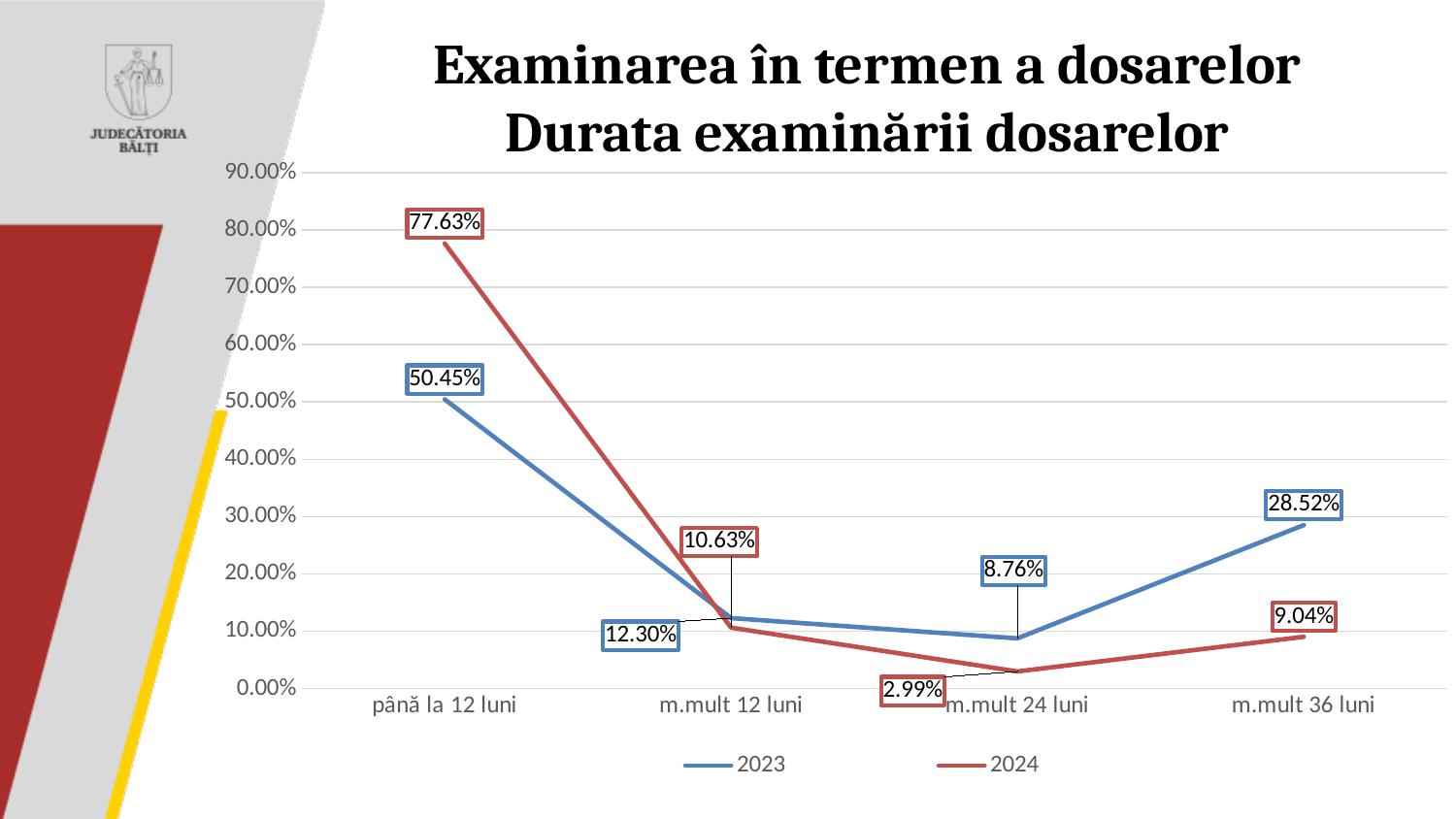
Which category has the highest value for the 2024 series? până la 12 luni How many series does the legend list? 2 Which category has the lowest value for the 2023 series? m.mult 24 luni How many categories are shown on the x axis? 4 What is the value for 2023 at "până la 12 luni"? 50.45% At "m.mult 36 luni", which series has the larger value, 2023 or 2024? 2023 What is the difference between the 2024 and 2023 values at "până la 12 luni"? 27.18% What is the value for 2023 at "m.mult 36 luni"? 28.52% Which colour is used for the 2024 series? red What is the value for 2024 at "până la 12 luni"? 77.63% What is the value for 2024 at "m.mult 24 luni"? 2.99% What kind of chart is shown on the slide? line chart